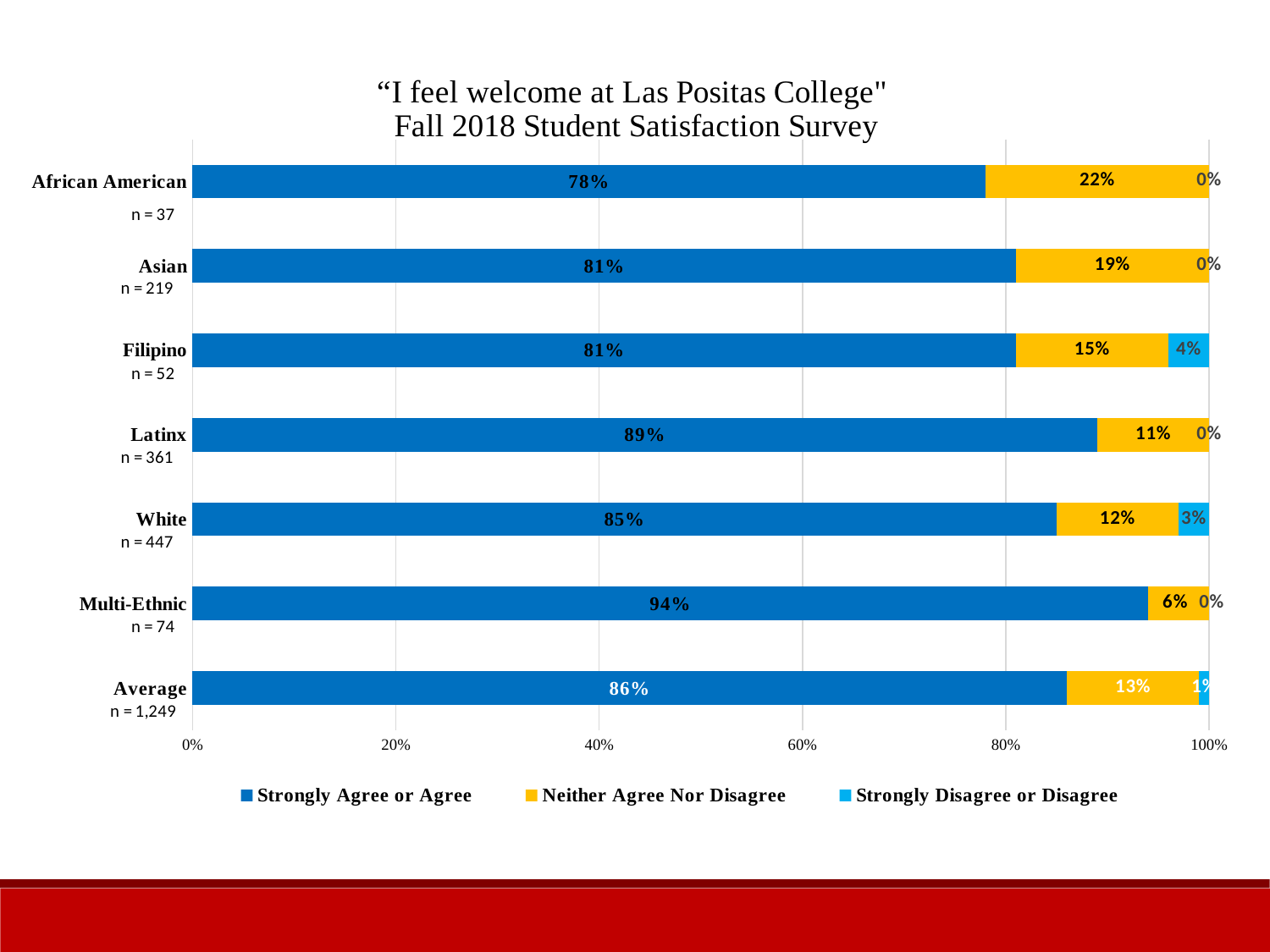
Which group has the lowest "Strongly Agree or Agree" percentage? African American How many groups (categories) are shown on the chart? 7 How many series does the legend list? 3 What is the sample size (n) for the Average row? 1,249 Is the "Strongly Agree or Agree" value for Average greater or less than 80%? greater What is the "Strongly Disagree or Disagree" value for Filipino students? 4% Which group has the highest "Strongly Agree or Agree" percentage? Multi-Ethnic What kind of chart is shown on the slide? Stacked bar chart What is the "Neither Agree Nor Disagree" value for Asian students? 19% What is the difference between the "Strongly Agree or Agree" percentages for Latinx and White students? 4% What percentage of African American students responded "Strongly Agree or Agree"? 78% Which has a larger "Neither Agree Nor Disagree" share, African American or Latinx? African American